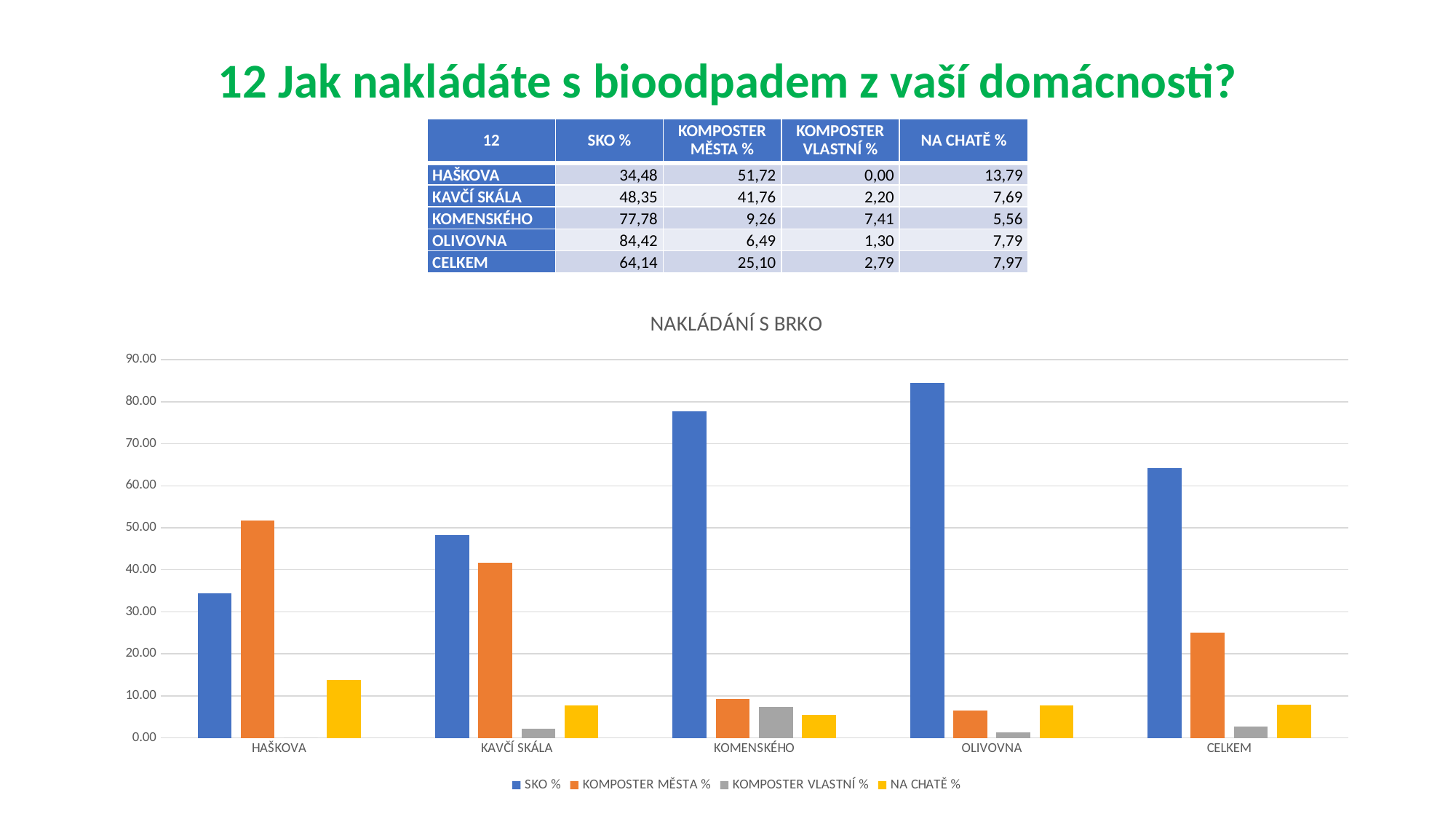
What is the difference between the SKO % values for KOMENSKÉHO and KAVČÍ SKÁLA? 29,43 What is the title of the chart on the slide? NAKLÁDÁNÍ S BRKO What is the SKO % value for OLIVOVNA? 84,42 How many categories are shown on the x axis of the NAKLÁDÁNÍ S BRKO chart? 5 Which is larger for HAŠKOVA: SKO % or KOMPOSTER MĚSTA %? KOMPOSTER MĚSTA % Which category has the highest SKO % value? OLIVOVNA What is the KOMPOSTER MĚSTA % value for HAŠKOVA? 51,72 Is the SKO % value for CELKEM greater or less than 60.00? greater What is the NA CHATĚ % value for CELKEM? 7,97 Which category has the lowest KOMPOSTER VLASTNÍ % value? HAŠKOVA What type of chart is shown under the title NAKLÁDÁNÍ S BRKO? bar chart How many series does the legend of the NAKLÁDÁNÍ S BRKO chart list? 4